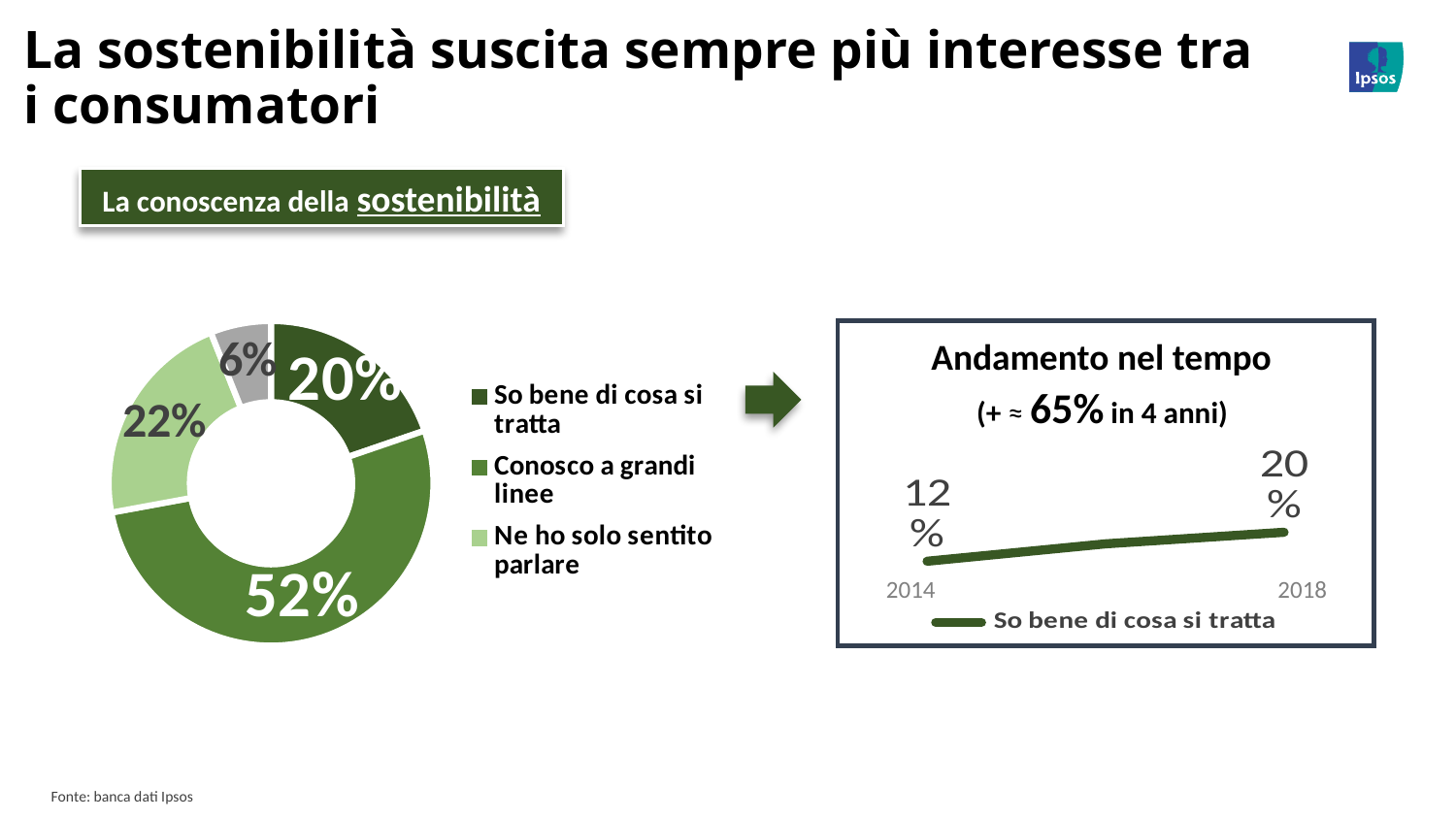
On the doughnut chart on the left, what percentage corresponds to "Conosco a grandi linee"? 52% On the doughnut chart on the left, what is the smallest percentage shown? 6% On the doughnut chart on the left, what is the difference between the "Conosco a grandi linee" share and the "So bene di cosa si tratta" share? 32% What type of chart is the "Andamento nel tempo" chart? line chart On the doughnut chart on the left, which is larger: "Ne ho solo sentito parlare" or "So bene di cosa si tratta"? Ne ho solo sentito parlare In the "Andamento nel tempo" chart, what is the value for 2018? 20% On the doughnut chart on the left, what percentage corresponds to "So bene di cosa si tratta"? 20% In the "Andamento nel tempo" chart, what is the value for 2014? 12% On the doughnut chart on the left, what percentage corresponds to "Ne ho solo sentito parlare"? 22% On the doughnut chart on the left, which legend category has the largest share? Conosco a grandi linee In the "Andamento nel tempo" chart, does the value rise or fall from 2014 to 2018? rise How many entries does the legend of the doughnut chart on the left list? 3